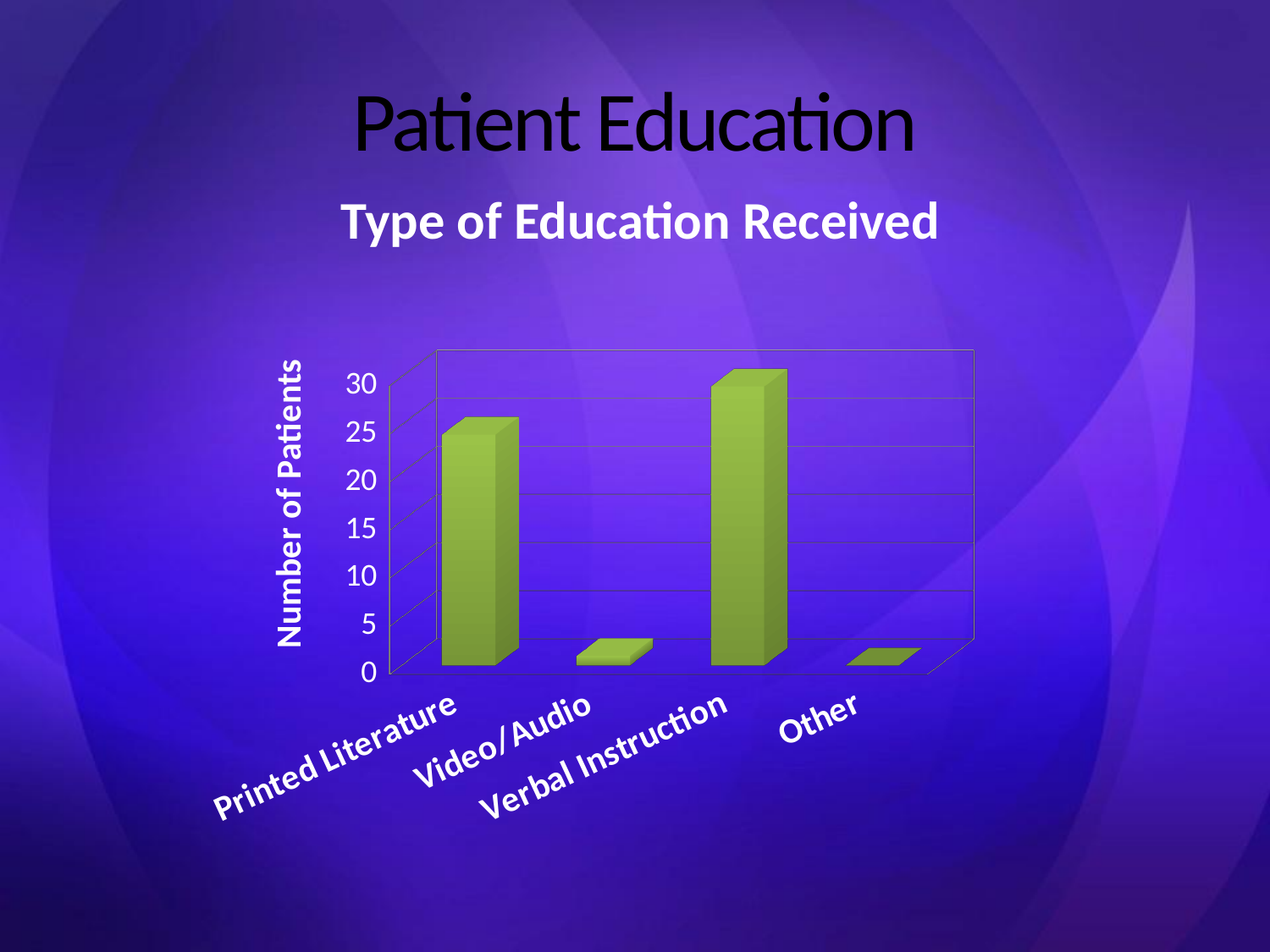
Is the value for Verbal Instruction greater or less than 25? greater Is the value for Printed Literature greater or less than 20? greater Which has more patients, Verbal Instruction or Printed Literature? Verbal Instruction What is the label on the vertical axis of the chart? Number of Patients What is the title of the chart? Type of Education Received Which has more patients, Printed Literature or Video/Audio? Printed Literature Is the value for Printed Literature greater or less than 30? less What type of chart is shown on the slide? Bar chart How many categories are shown on the x axis of the chart? 4 Which category has the highest number of patients? Verbal Instruction